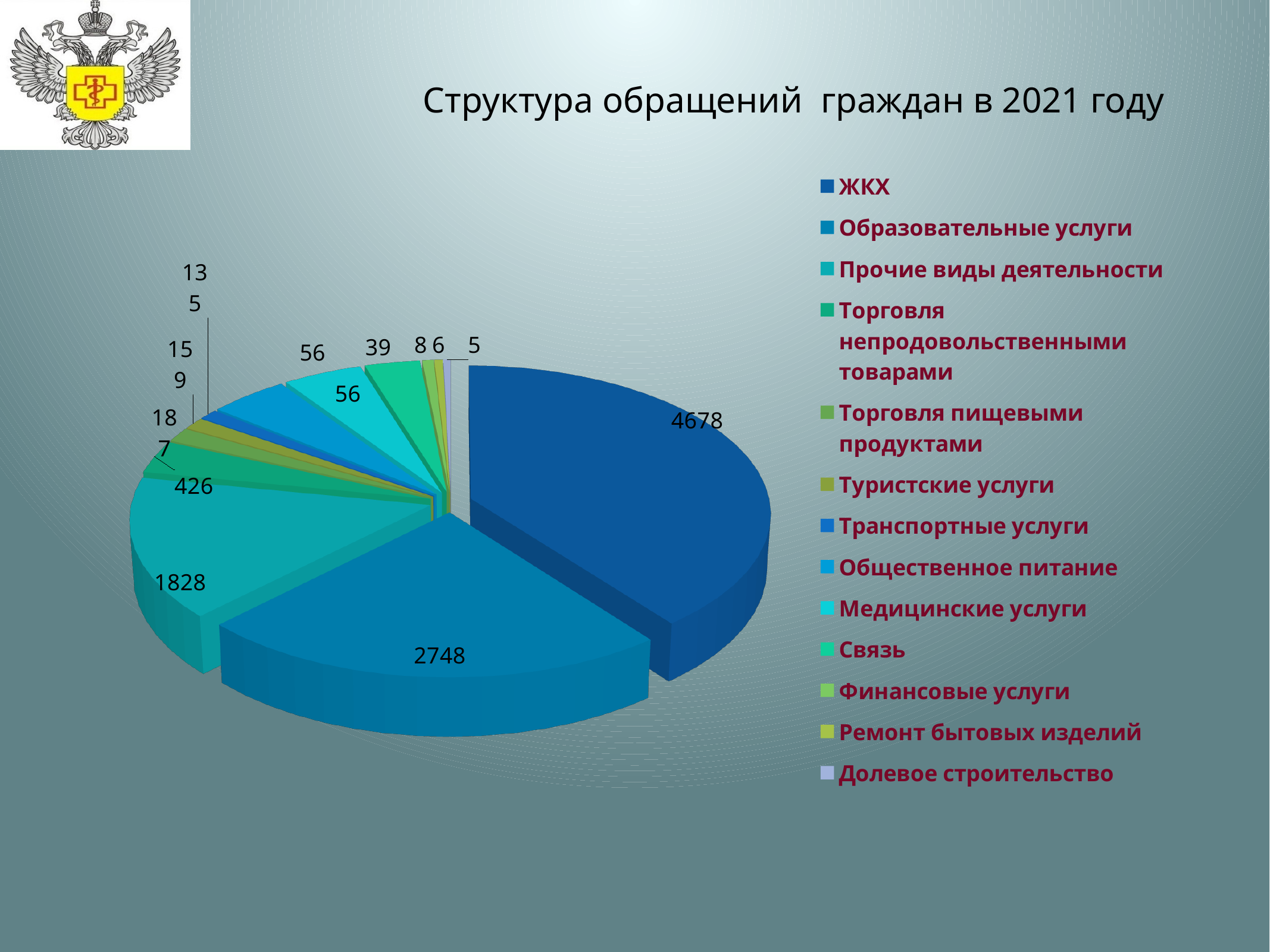
What kind of chart is shown on the slide? pie chart What is the title of the chart? Структура обращений граждан в 2021 году How many categories does the legend list? 13 What is the value for ЖКХ? 4678 What is the value for Образовательные услуги? 2748 What is the difference between the values for ЖКХ and Образовательные услуги? 1930 Which is larger, the value for Образовательные услуги or the value for Прочие виды деятельности? Образовательные услуги What is the value for Связь? 39 Which category has the smallest slice? Долевое строительство What is the value for Торговля непродовольственными товарами? 426 Which category has the largest slice? ЖКХ What is the value for Прочие виды деятельности? 1828